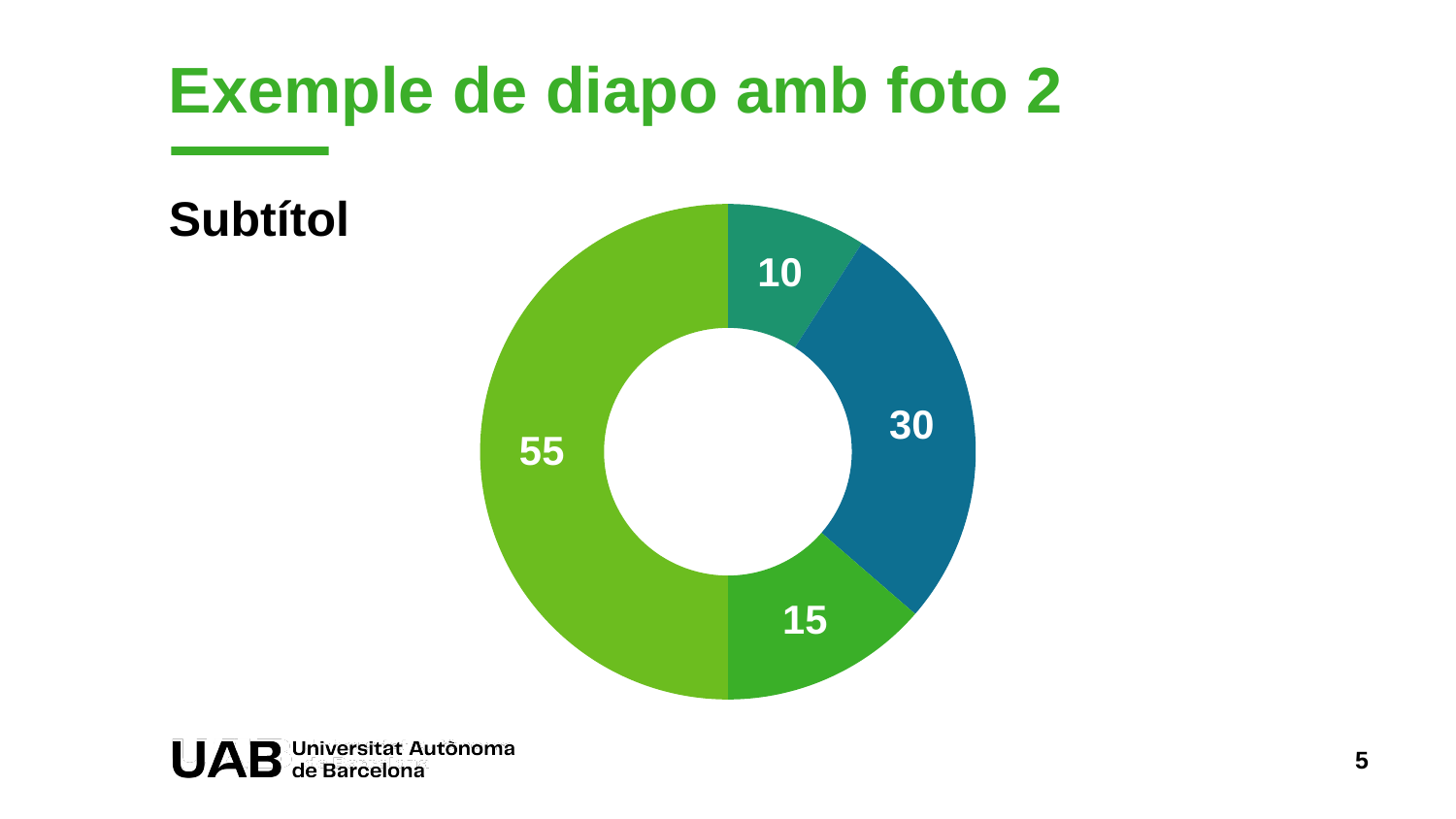
How many slices does the doughnut chart have? 4 What is the total of all the values in the doughnut chart? 110 Which is larger, the dark blue slice or the slice labelled 15? The dark blue slice (30) What value is shown on the dark blue slice of the doughnut chart? 30 What value is shown on the largest, light green slice of the doughnut chart? 55 What is the difference between the largest slice (55) and the slice labelled 30? 25 What is the smallest value shown in the doughnut chart? 10 What is the largest value shown in the doughnut chart? 55 What is the difference between the slices labelled 15 and 10? 5 What share of the whole does the slice labelled 55 represent? 50% What is the title of the slide containing the doughnut chart? Exemple de diapo amb foto 2 What kind of chart is shown on the slide? Doughnut chart